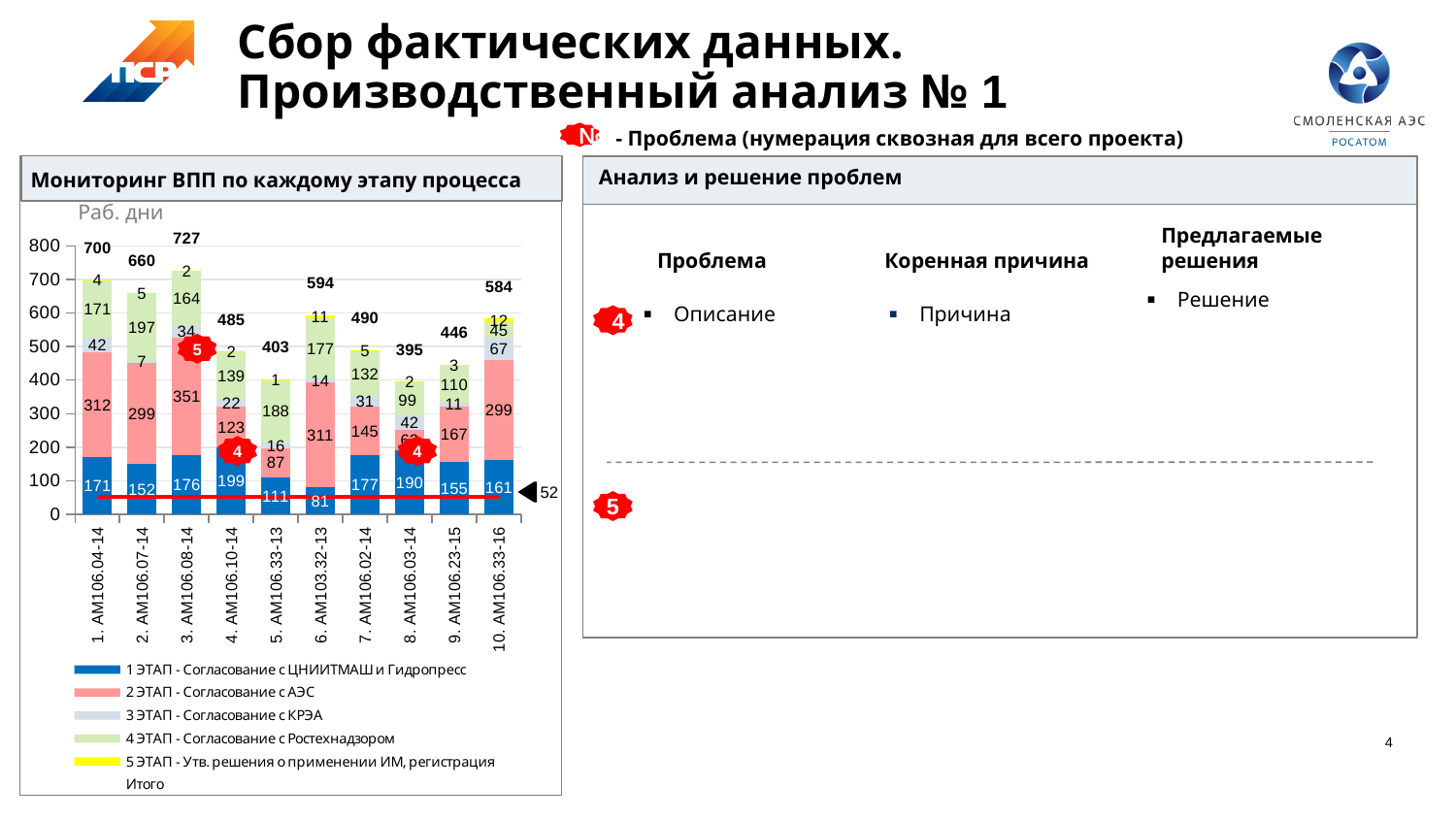
Which category has the lowest total value in the chart? 8. AM106.03-14 How many categories (bars) are plotted along the x axis of the chart? 10 What is the difference between the total for 1. AM106.04-14 and the total for 2. AM106.07-14? 40 Which has the larger value for '4 ЭТАП - Согласование с Ростехнадзором': 2. AM106.07-14 or 6. AM103.32-13? 2. AM106.07-14 What is the value of '2 ЭТАП - Согласование с АЭС' for category 1. AM106.04-14? 312 What is the value of '3 ЭТАП - Согласование с КРЭА' for category 10. AM106.33-16? 67 Which category has the highest total value in the chart? 3. AM106.08-14 What unit label is shown above the vertical axis of the chart? Раб. дни How many entries does the chart's legend list? 6 What kind of chart is shown on the slide? Stacked bar chart combined with a line (the red target line at 52) What is the value of '1 ЭТАП - Согласование с ЦНИИТМАШ и Гидропресс' for category 4. AM106.10-14? 199 What is the total value of the stacked bar for 5. AM106.33-13? 403